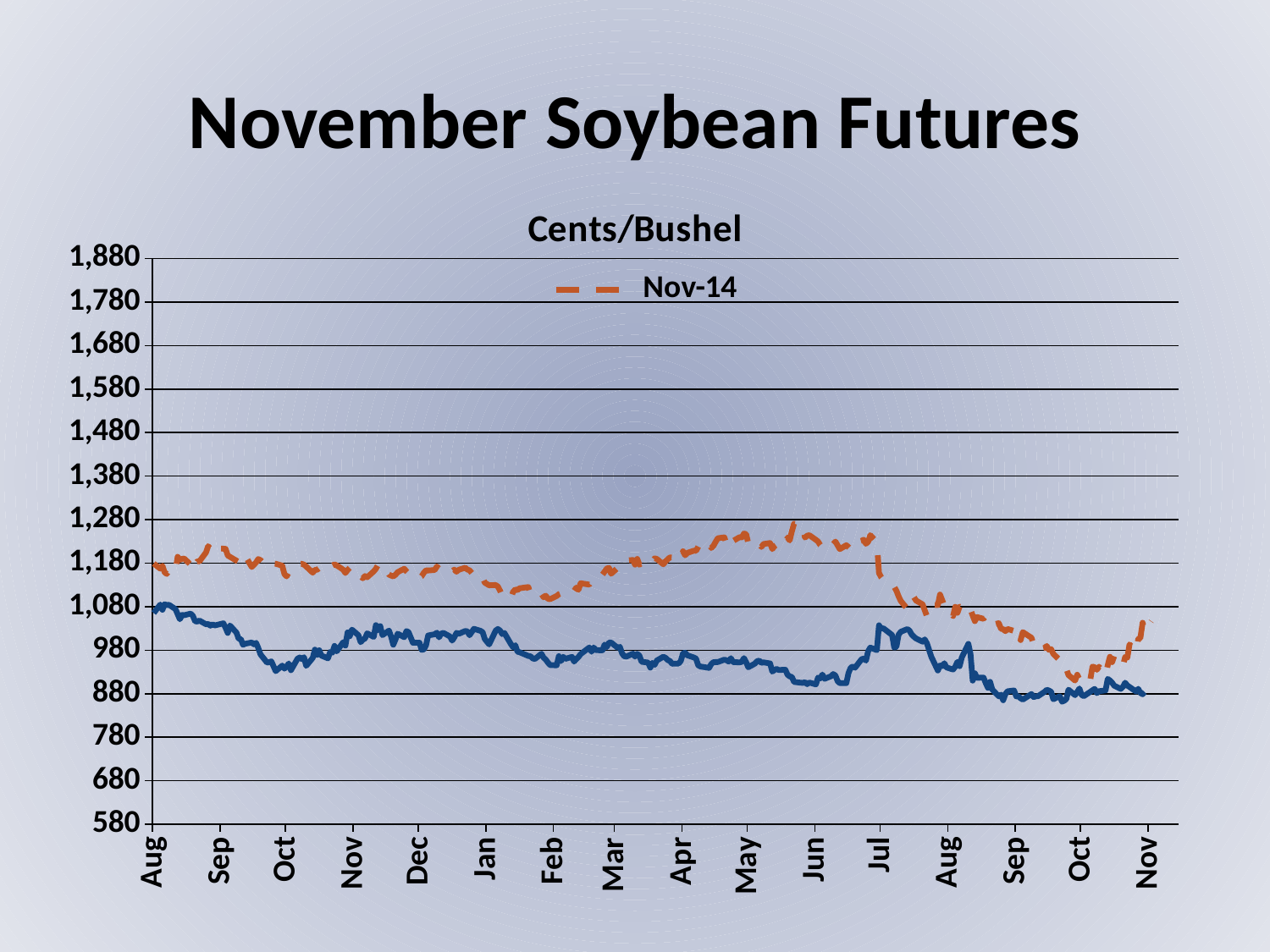
Is the Nov-14 value at the second Oct label greater or less than 980? less At the Jun label, which is higher: the dashed Nov-14 line or the solid blue line? Nov-14 What is the title printed above the chart's plot area? Cents/Bushel How many series does the chart legend list? 1 What kind of chart is shown on the slide? line chart Is the Nov-14 value at the first Aug label greater or less than 1,080? greater Is the Nov-14 value at the Jun label greater or less than 1,180? greater Does the Nov-14 series rise or fall between the Jun label and the second Oct label? fall Does the Nov-14 series rise or fall between the Feb label and the May label? rise What is the name of the series shown in the chart legend? Nov-14 How many month labels are shown along the x axis? 16